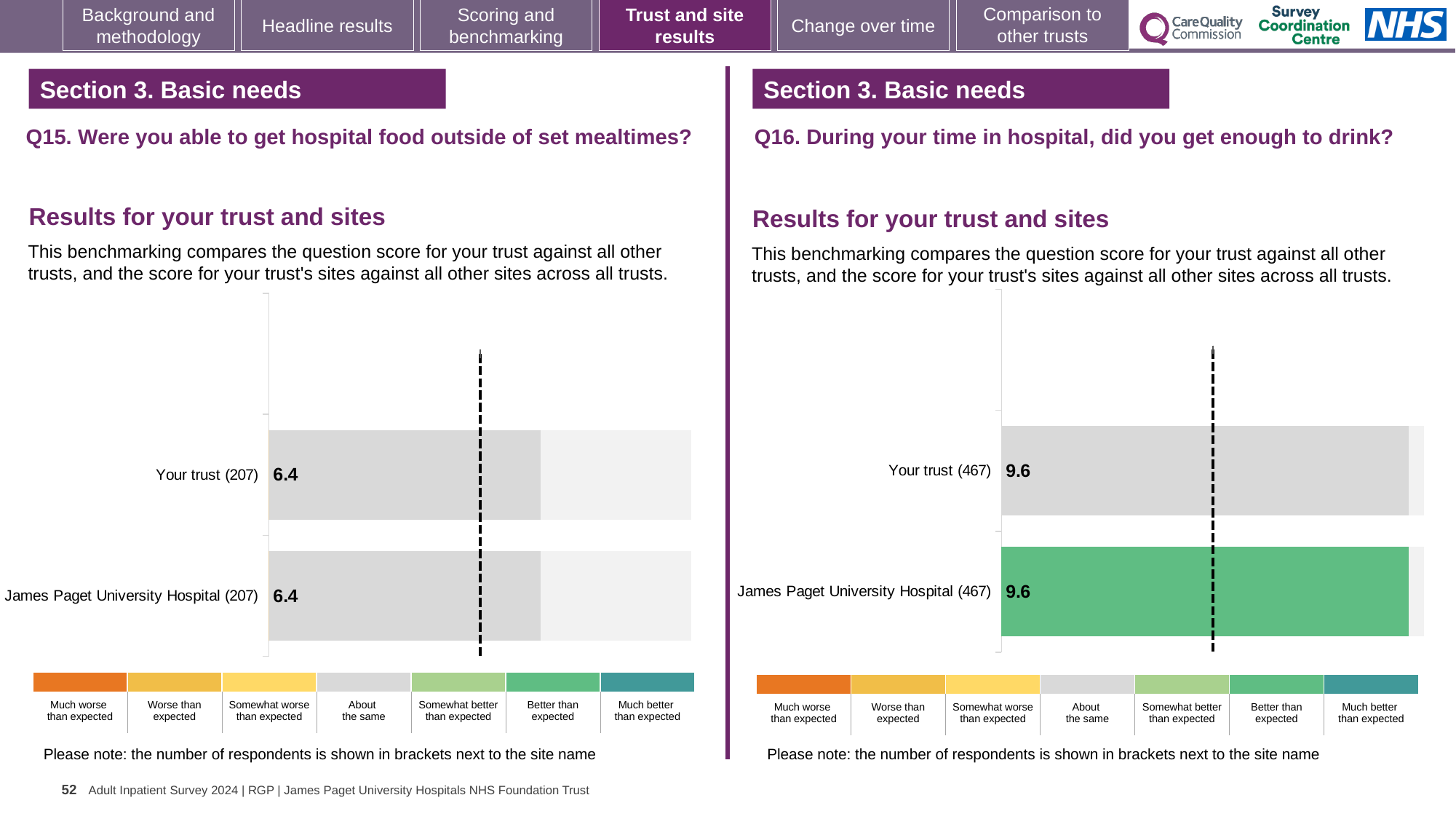
In the Q16 chart (right), how many respondents are shown in brackets for James Paget University Hospital? 467 In the Q16 chart (right), what colour is the bar for James Paget University Hospital? Green In the Q16 chart (right), what is the difference between the score for James Paget University Hospital and the score for Your trust? 0 In the Q15 chart (left), what is the score for James Paget University Hospital? 6.4 What kind of chart is used for the Q16 results (right)? Bar chart In the Q15 chart (left), what is the score for Your trust? 6.4 In the Q16 chart (right), what is the score for James Paget University Hospital? 9.6 In the Q15 chart (left), what is the difference between the score for Your trust and the score for James Paget University Hospital? 0 In the Q16 chart (right), what is the score for Your trust? 9.6 How many bars are plotted in the Q15 chart (left)? 2 How many bars are plotted in the Q16 chart (right)? 2 In the Q15 chart (left), how many respondents are shown in brackets for Your trust? 207